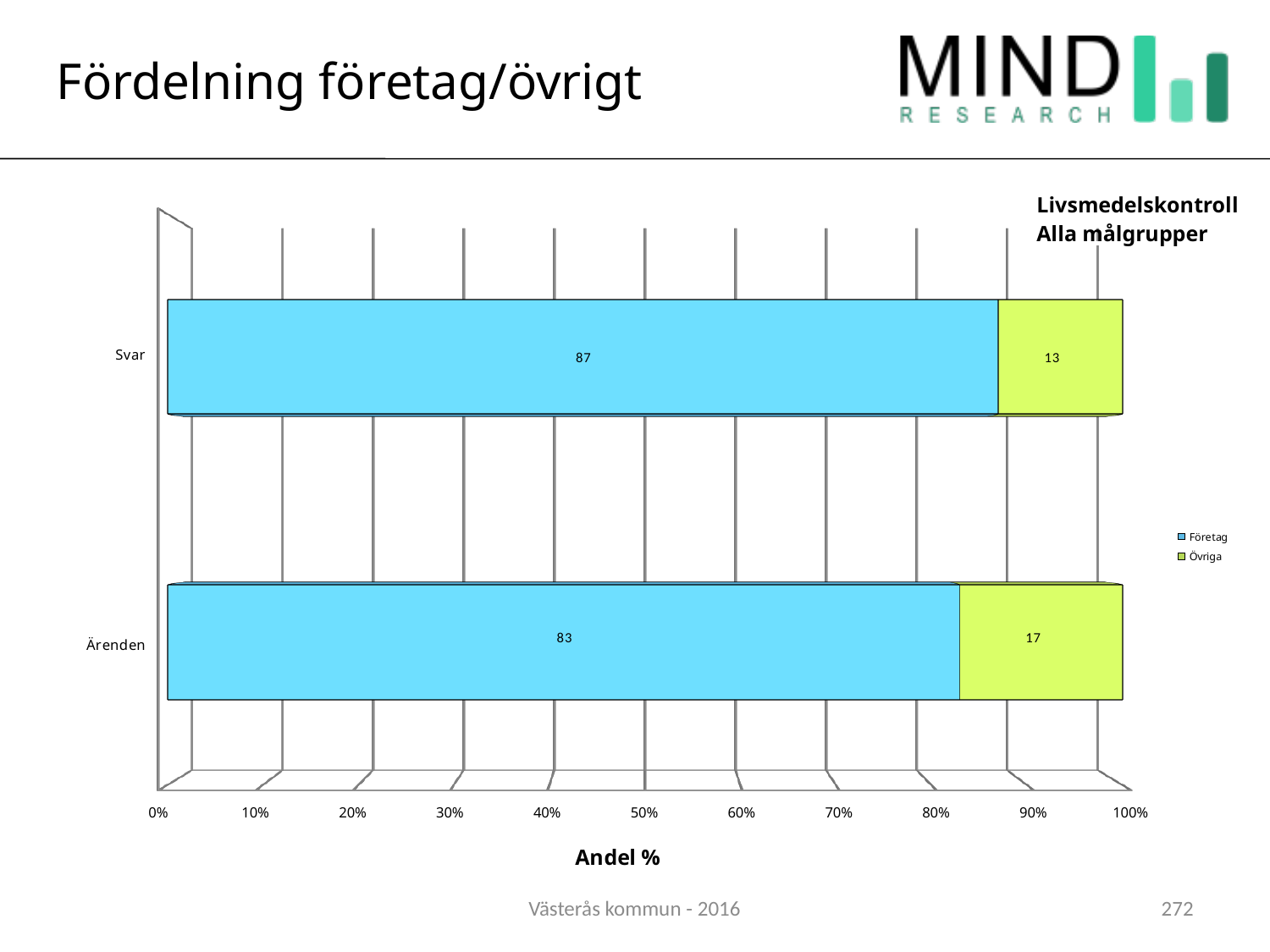
What is the value for Företag in the Ärenden bar? 83 What is the difference between the Företag values for Svar and Ärenden? 4 What is the value for Företag in the Svar bar? 87 What is the value for Övriga in the Svar bar? 13 What is the total of the Ärenden stacked bar? 100 What is the label of the x axis? Andel % How many series does the legend list? 2 What kind of chart is shown on the slide? Stacked bar chart Which category has the higher Företag value, Svar or Ärenden? Svar What is the value for Övriga in the Ärenden bar? 17 How many categories are shown on the y axis? 2 Which category has the lowest Övriga value? Svar